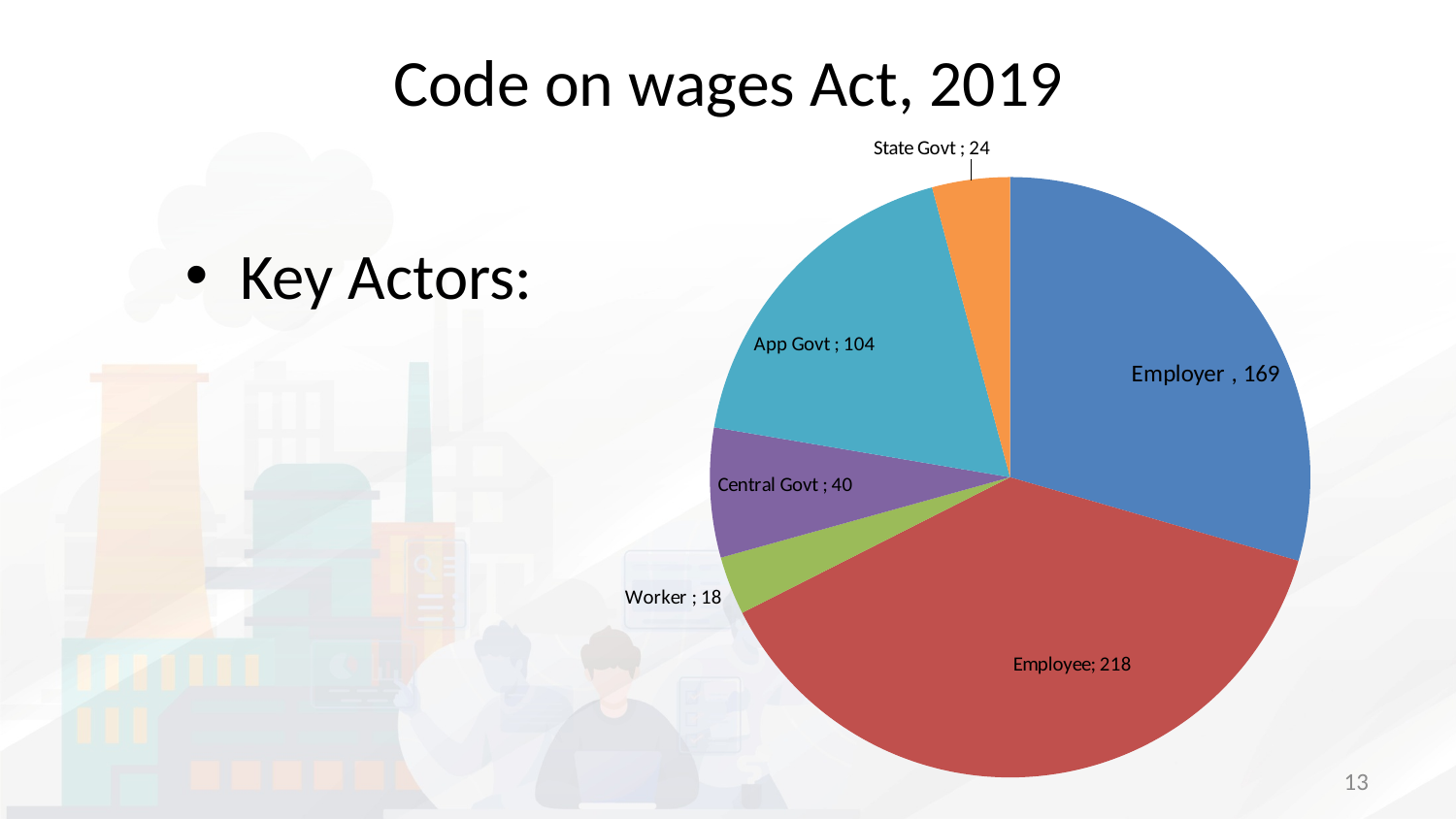
What is the value for Central Govt in the pie chart? 40 What is the difference between the values for Employee and Employer? 49 Which is larger, the value for App Govt or the value for Central Govt? App Govt What is the total of all the values shown in the pie chart? 573 Which category has the largest slice in the pie chart? Employee How many categories are shown in the pie chart? 6 What kind of chart is shown on the slide? Pie chart What is the value for State Govt in the pie chart? 24 What is the value for App Govt in the pie chart? 104 What is the value for Employer in the pie chart? 169 Which category has the smallest slice in the pie chart? Worker What is the value for Employee in the pie chart? 218